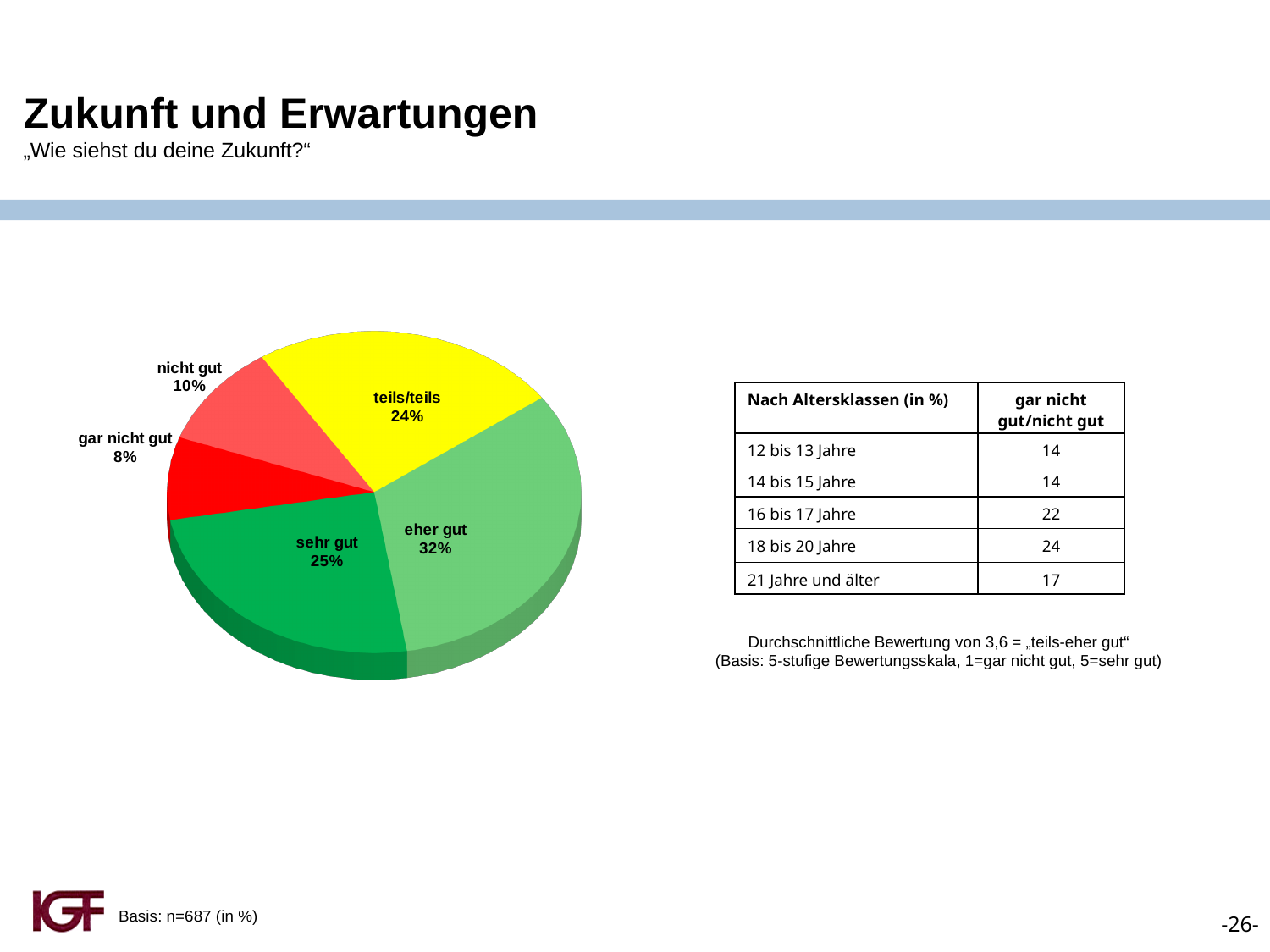
What share of the pie does "sehr gut" have? 25% Which slice of the pie is the smallest? gar nicht gut What share of the pie does "gar nicht gut" have? 8% Which is larger, the share for "nicht gut" or the share for "gar nicht gut"? nicht gut What share of the pie does "nicht gut" have? 10% What kind of chart is shown on the slide? pie chart How many slices does the pie chart have? 5 What is the difference in percentage points between "eher gut" and "sehr gut"? 7 Which slice of the pie is the largest? eher gut What colour is the "teils/teils" slice of the pie? yellow